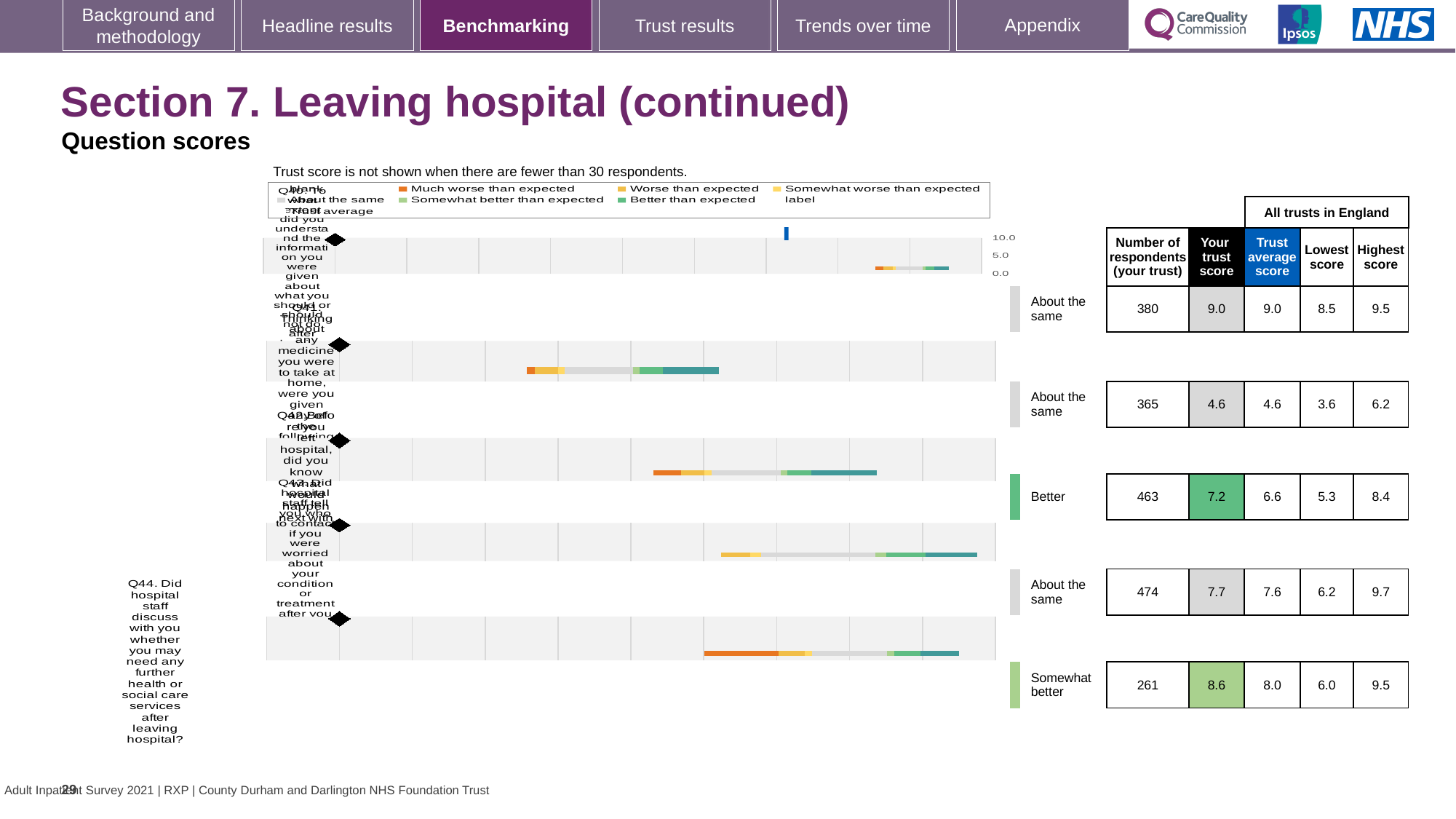
By how much does the trust score for Q44 exceed the trust average score? 0.6 What benchmark category is shown for Q44? Somewhat better What kind of chart is used to show the question scores on this slide? bar chart How many question rows are plotted in the benchmarking chart? 5 What is the lowest score across all trusts in England for Q44? 6.0 For Q44, is 'Your trust score' higher or lower than the trust average score? higher What is the highest score across all trusts in England for Q44? 9.5 What is the trust average score for Q44? 8.0 How many respondents are shown for Q44? 261 What is the lowest 'Your trust score' value shown in the table? 4.6 What is the highest 'Your trust score' value shown in the table? 9.0 What is 'Your trust score' for Q44 (Did hospital staff discuss with you whether you may need any further health or social care services after leaving hospital?)? 8.6